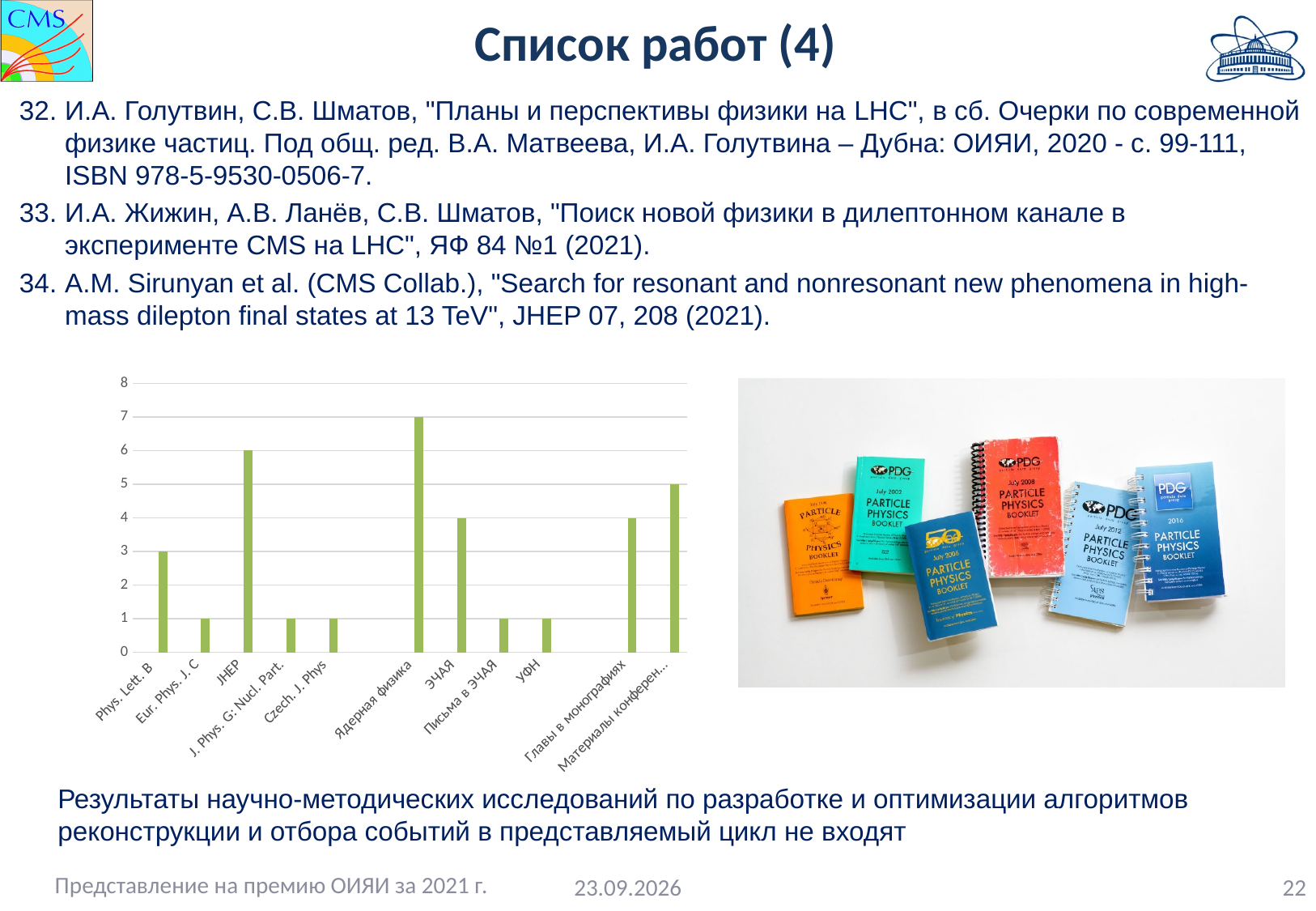
What type of chart is shown on the slide? bar chart What is the value for ЭЧАЯ in the bar chart? 4 What is the value for Ядерная физика in the bar chart? 7 Which is larger in the bar chart, the value for JHEP or the value for ЭЧАЯ? JHEP What is the maximum value shown on the y axis of the bar chart? 8 What is the difference between the values for Ядерная физика and JHEP? 1 What is the value for Phys. Lett. B in the bar chart? 3 Is the value for Главы в монографиях greater or less than 2? greater How many categories are shown on the x axis of the bar chart? 11 Which category has the highest value in the bar chart? Ядерная физика What is the value for Eur. Phys. J. C in the bar chart? 1 What is the value for JHEP in the bar chart? 6